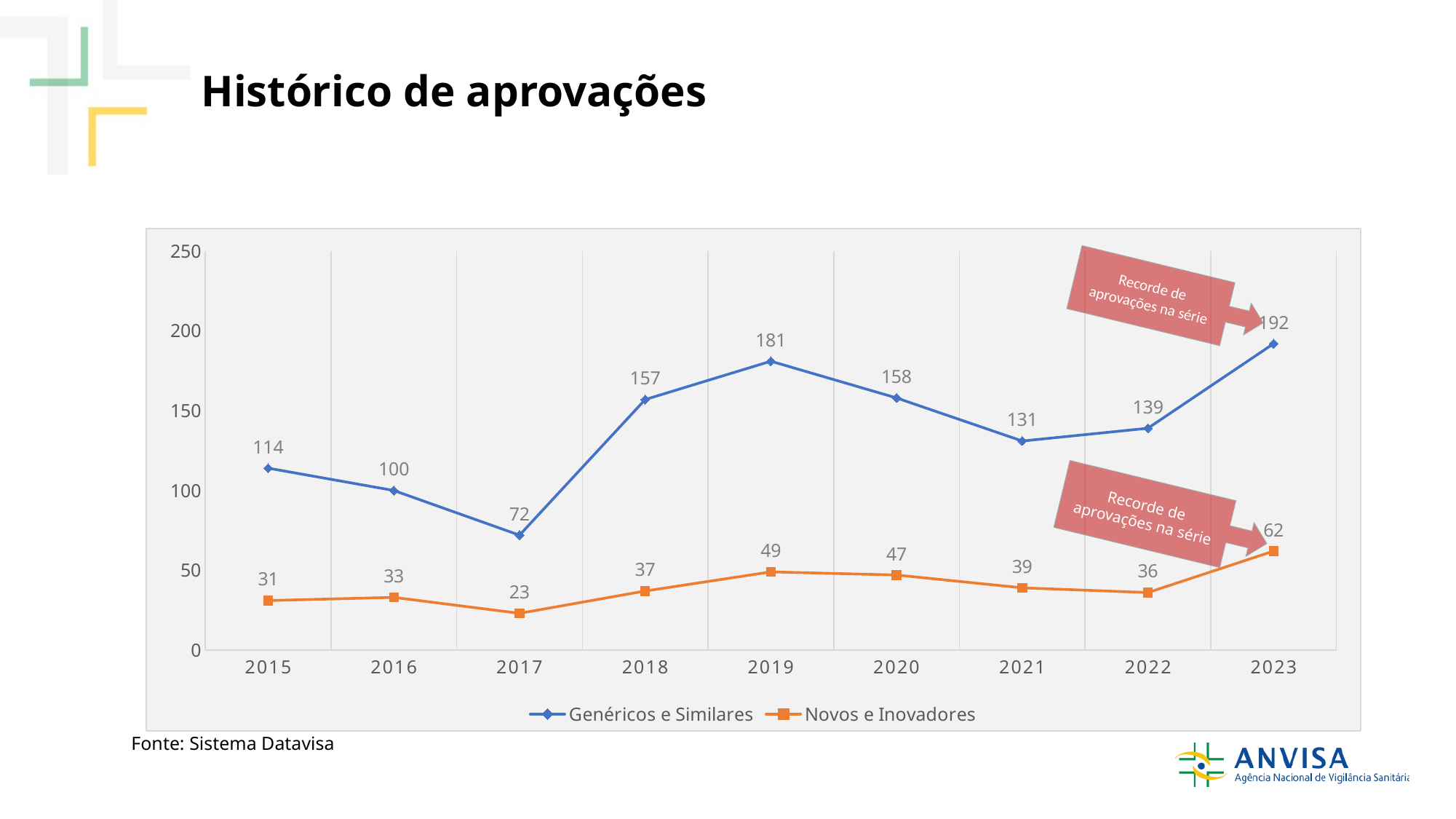
How many series does the legend list? 2 What is the value for Genéricos e Similares in 2023? 192 How many years are shown on the x axis? 9 What is the value for Genéricos e Similares in 2019? 181 In which year is the value for Genéricos e Similares lowest? 2017 In which year is the value for Novos e Inovadores highest? 2023 What is the source cited below the chart? Sistema Datavisa What kind of chart is shown on the slide? Line chart What is the difference between the Genéricos e Similares values for 2023 and 2022? 53 What is the value for Novos e Inovadores in 2017? 23 Which is larger: the Novos e Inovadores value in 2019 or in 2020? 2019 What is the difference between the Genéricos e Similares and Novos e Inovadores values in 2015? 83